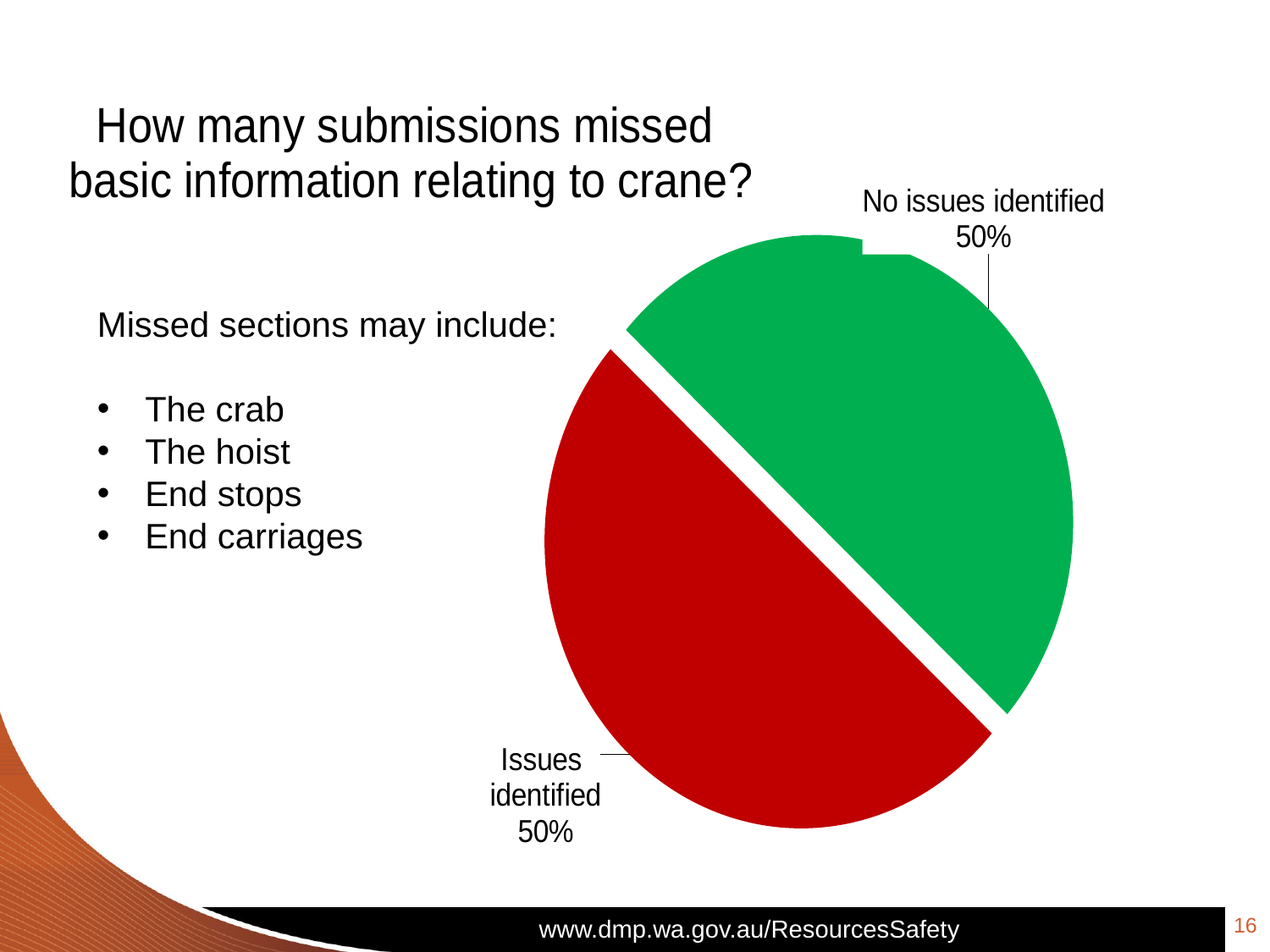
What is the total of the two slices shown in the pie chart? 100% What colour is the 'No issues identified' slice? green What percentage of submissions had issues identified? 50% How many slices does the pie chart have? 2 What kind of chart is shown on the slide? pie chart What share of the pie does the 'Issues identified' slice represent? 50% What is the difference between the 'Issues identified' and 'No issues identified' shares? 0% Is the value for 'Issues identified' greater or less than 60%? less What colour is the 'Issues identified' slice? red What percentage of submissions had no issues identified? 50% Is the value for 'No issues identified' greater or less than 40%? greater